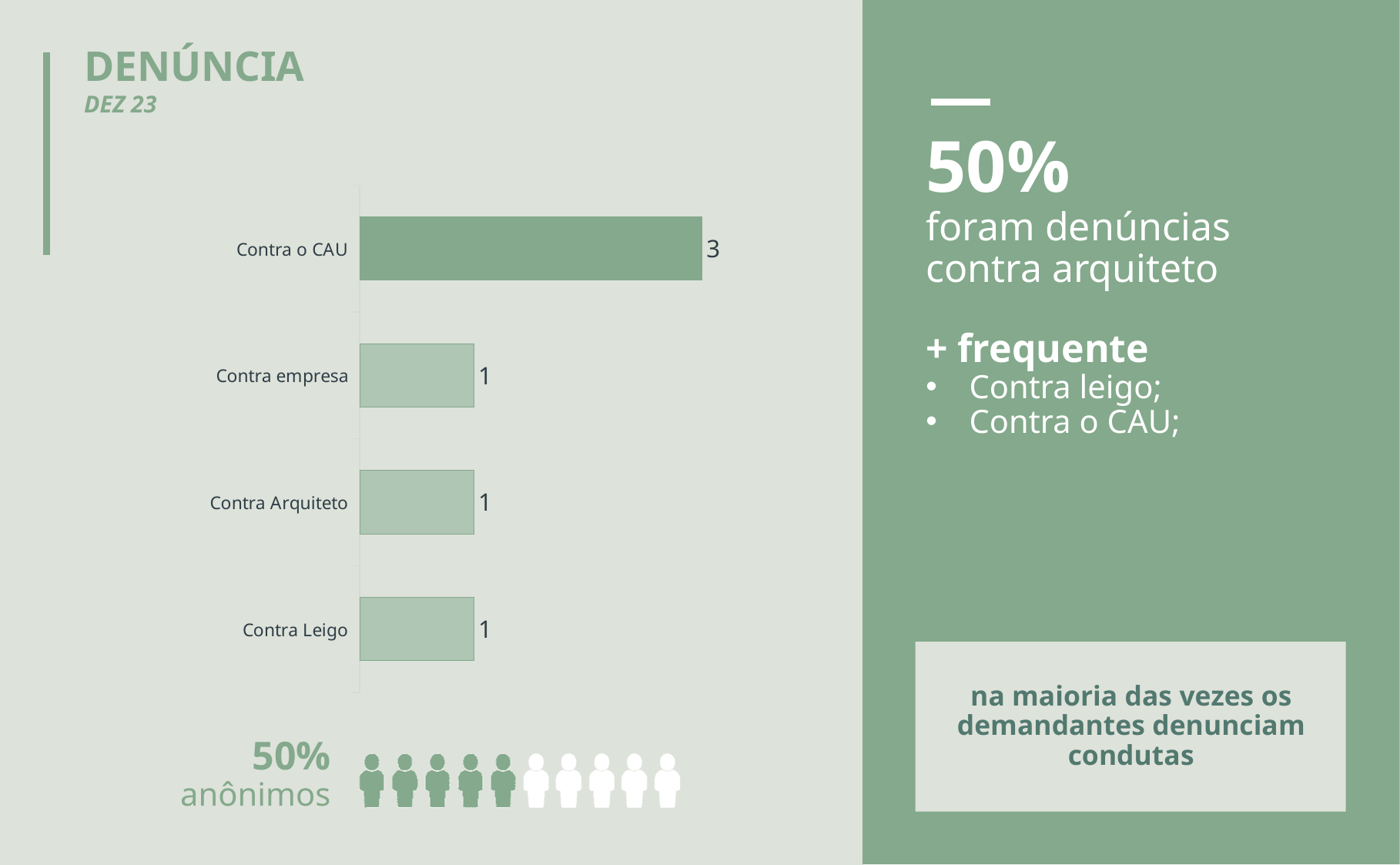
What is the value for Contra Leigo? 1 What is the title of the slide containing the chart? DENÚNCIA What is the value for Contra Arquiteto? 1 Which category has the highest value? Contra o CAU What is the value for Contra empresa? 1 Which is larger, the value for Contra o CAU or the value for Contra Leigo? Contra o CAU What is the difference between the values for Contra o CAU and Contra empresa? 2 What kind of chart is shown on the slide? Bar chart What is the value for Contra o CAU? 3 Which category is listed at the top of the chart? Contra o CAU What is the total of all the values shown in the chart? 6 How many categories are shown in the chart? 4